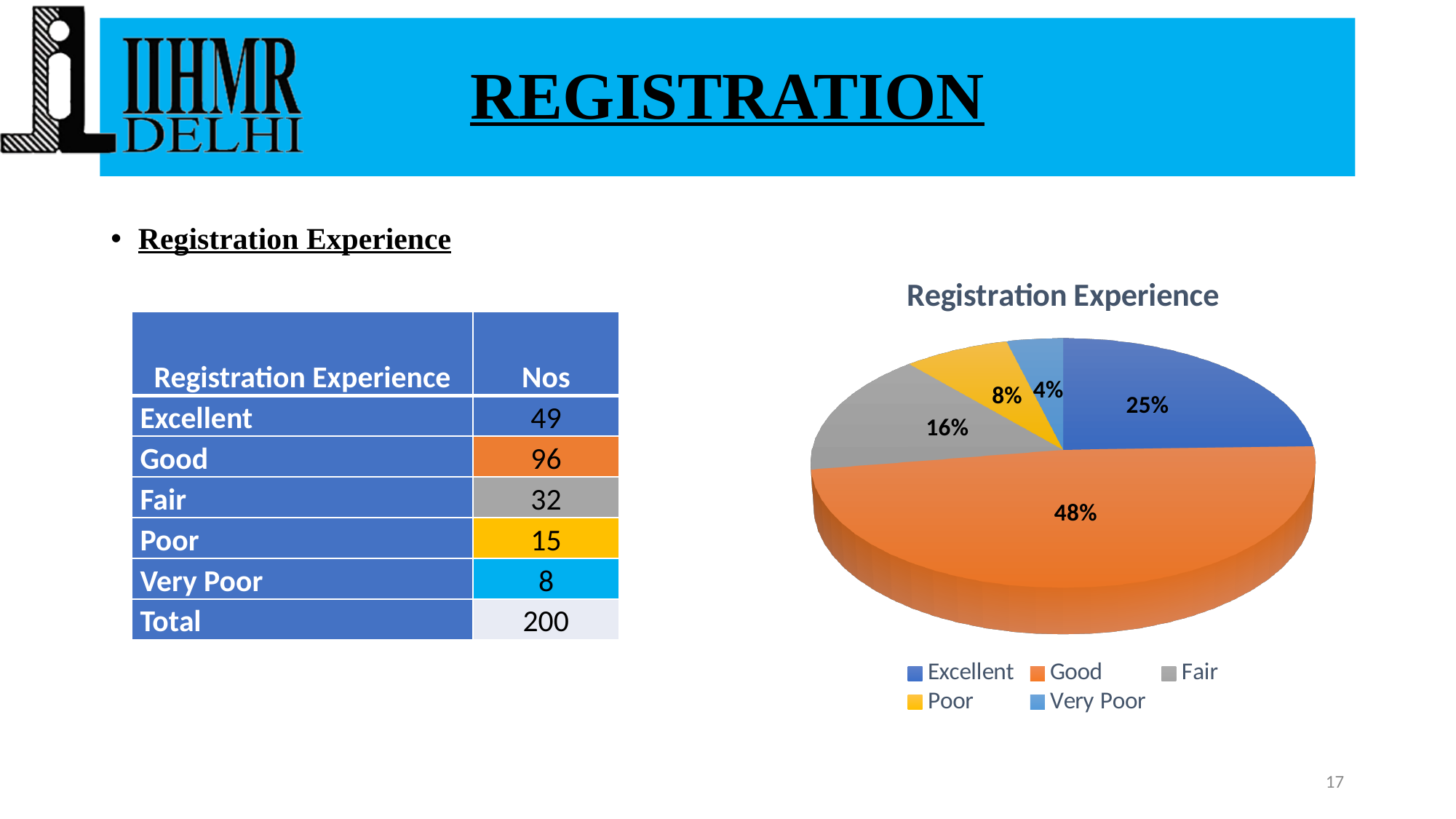
What type of chart is shown on the slide? Pie chart What is the difference in percentage points between the Good and Excellent slices? 23% Which category has the largest slice of the pie? Good What percentage of the pie does the Excellent slice represent? 25% What percentage of the pie does the Very Poor slice represent? 4% What percentage of the pie does the Fair slice represent? 16% Which category has the smallest slice of the pie? Very Poor What colour is the Poor slice in the pie chart? Yellow What is the title of the chart? Registration Experience Which slice is larger, Fair or Poor? Fair How many categories does the legend list? 5